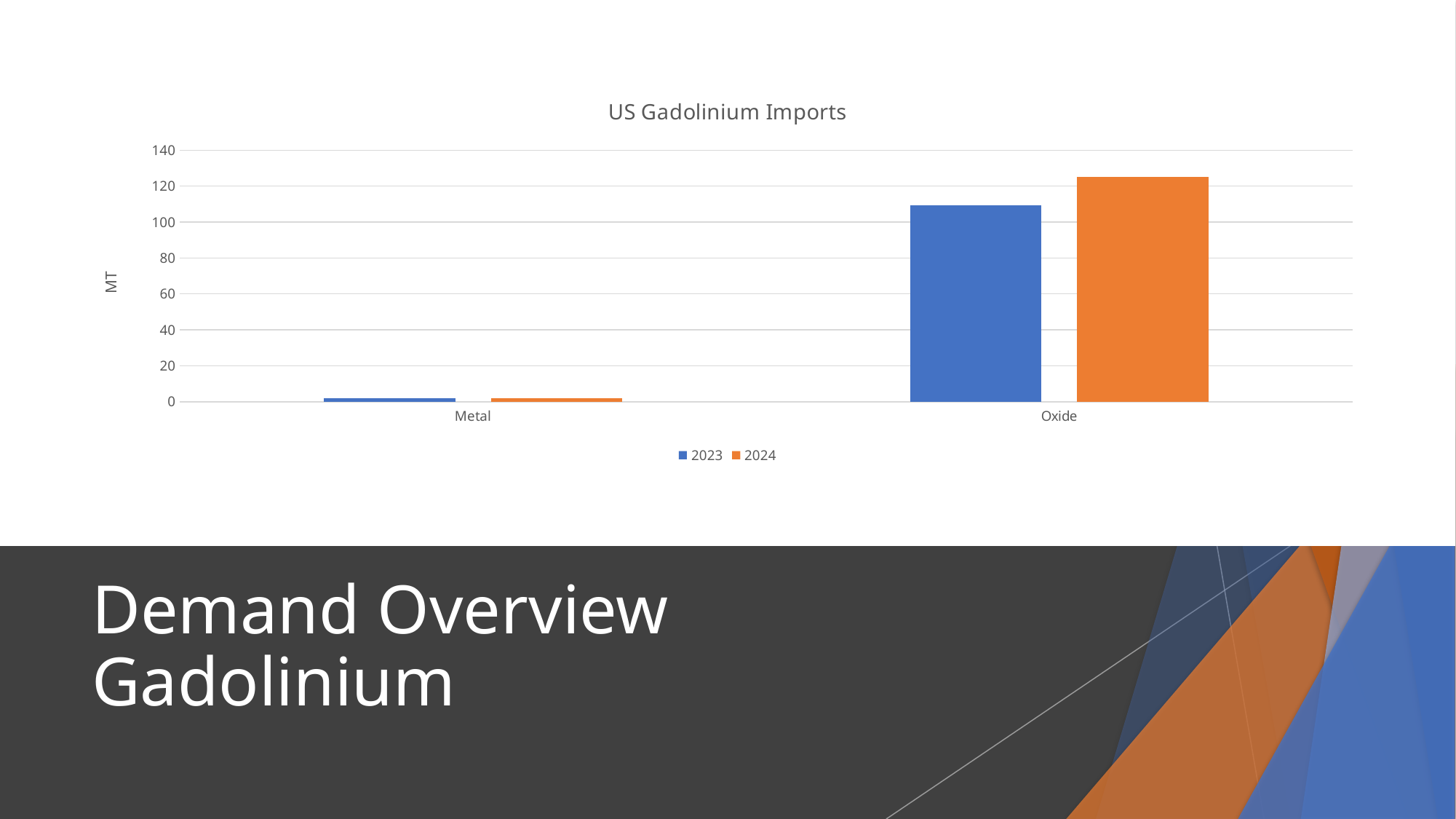
Which category has the lowest imports in 2023? Metal Is the 2023 value for Oxide greater or less than 100? greater Is the 2024 value for Oxide greater or less than 140? less How many series does the legend list? 2 What is the label on the vertical axis? MT For Oxide, which year has the larger value, 2023 or 2024? 2024 How many categories are shown on the x axis? 2 What is the title of the chart? US Gadolinium Imports Which category has the highest imports in 2024? Oxide What kind of chart is shown on the slide? bar chart Is the 2024 value for Oxide greater or less than 120? greater